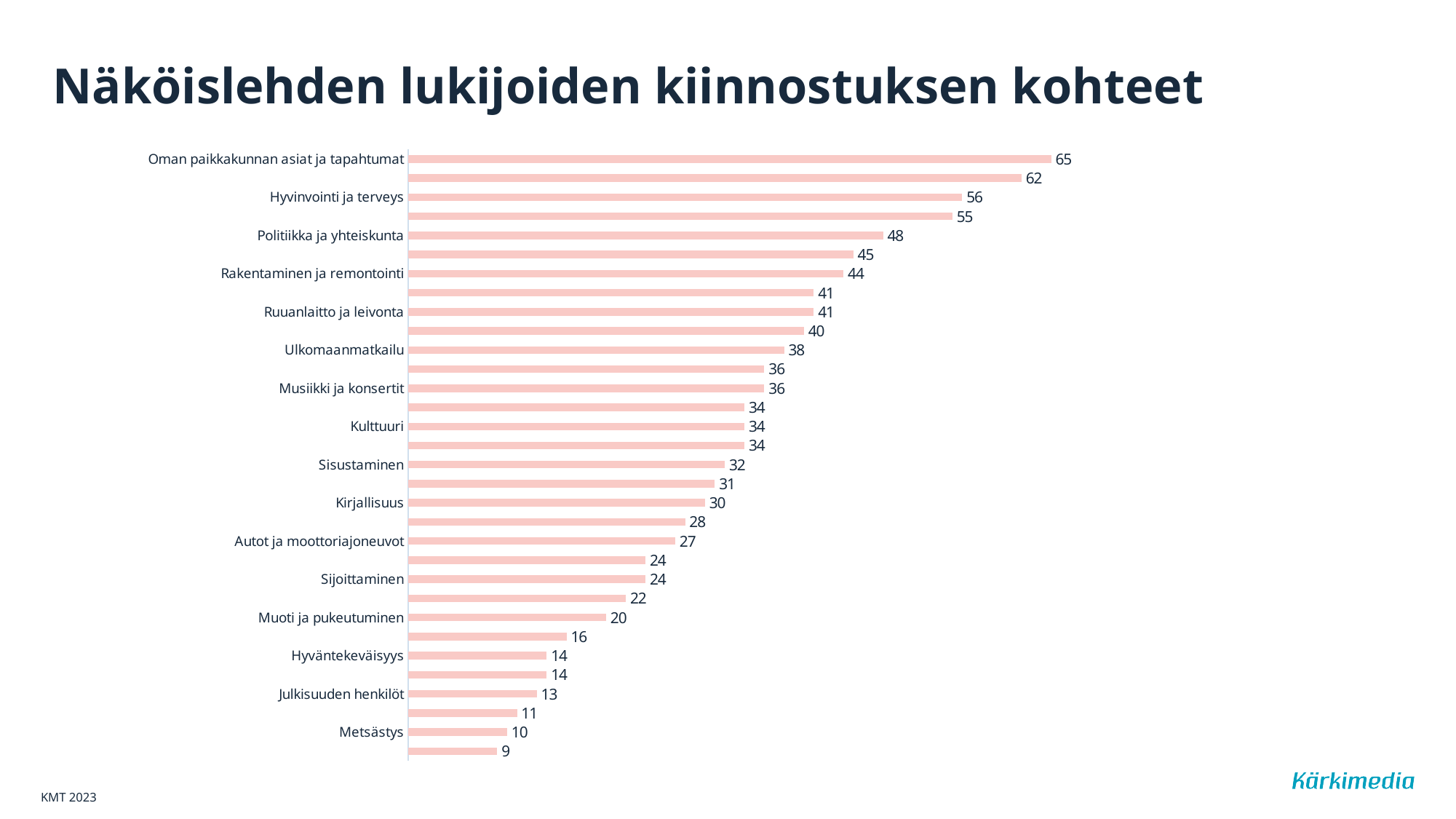
Which labelled category has the highest value? Oman paikkakunnan asiat ja tapahtumat Which is larger, the value for Rakentaminen ja remontointi or the value for Sijoittaminen? Rakentaminen ja remontointi What is the difference between the values for Oman paikkakunnan asiat ja tapahtumat and Hyvinvointi ja terveys? 9 What is the value for Oman paikkakunnan asiat ja tapahtumat? 65 What is the value for Metsästys? 10 What is the title of the slide? Näköislehden lukijoiden kiinnostuksen kohteet What is the difference between the values for Ulkomaanmatkailu and Kirjallisuus? 8 What is the value for Hyvinvointi ja terveys? 56 What kind of chart is shown on the slide? bar chart What is the value for Politiikka ja yhteiskunta? 48 What is the lowest value shown on the chart? 9 How many bars are plotted on the chart? 32